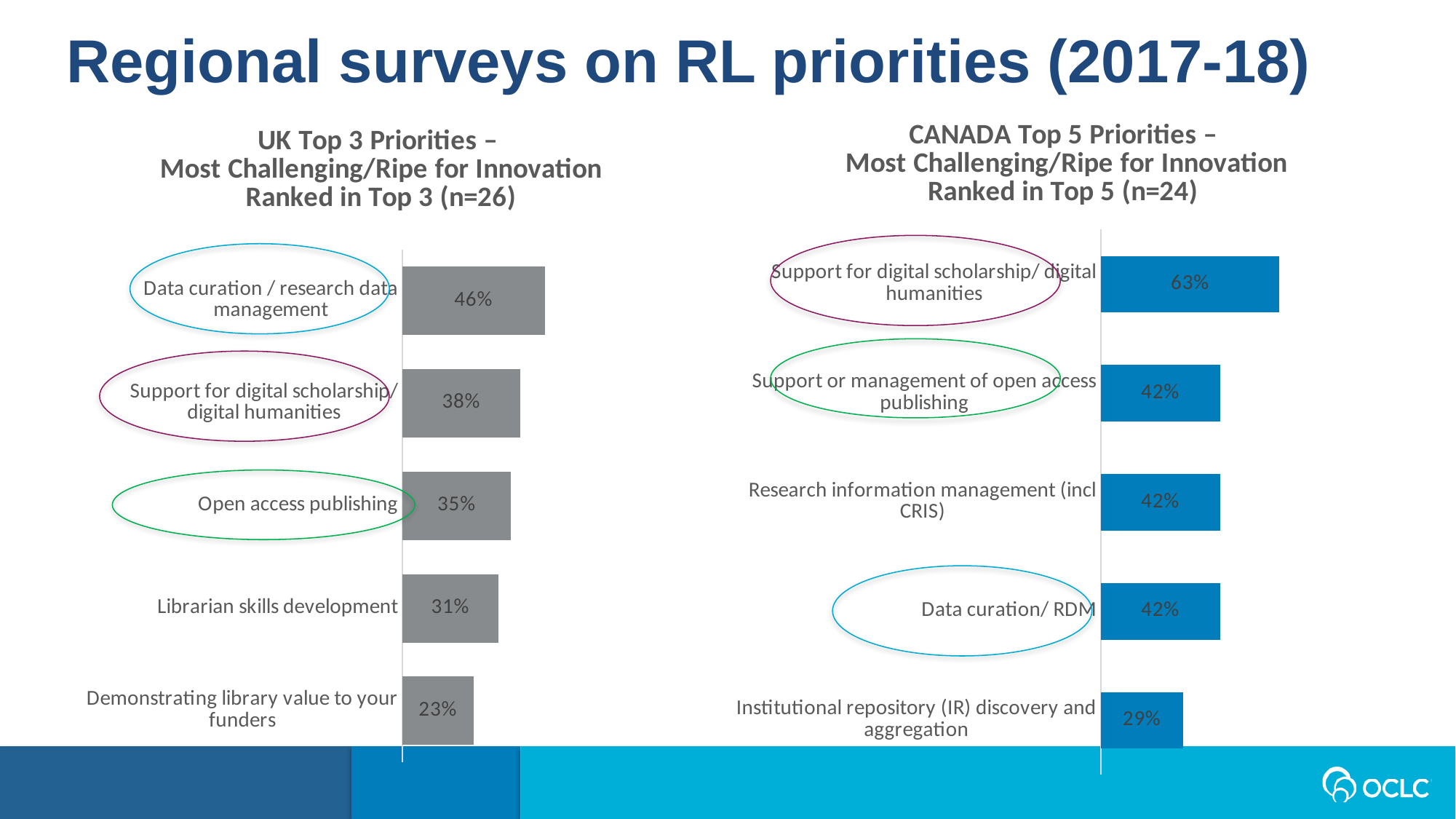
What type of chart is the UK Top 3 Priorities chart? Bar chart In the CANADA Top 5 Priorities chart, what is the value for Support for digital scholarship/ digital humanities? 63% In the CANADA Top 5 Priorities chart, which category has the highest value? Support for digital scholarship/ digital humanities In the UK Top 3 Priorities chart, what is the value for Librarian skills development? 31% In the CANADA Top 5 Priorities chart, what is the value for Institutional repository (IR) discovery and aggregation? 29% In the UK Top 3 Priorities chart, which is larger: Support for digital scholarship/ digital humanities or Librarian skills development? Support for digital scholarship/ digital humanities In the UK Top 3 Priorities chart, which category has the lowest value? Demonstrating library value to your funders In the UK Top 3 Priorities chart, what is the difference between Data curation / research data management and Open access publishing? 11% What colour are the bars in the CANADA Top 5 Priorities chart? Blue In the UK Top 3 Priorities chart, what is the value for Data curation / research data management? 46% How many categories are shown in the CANADA Top 5 Priorities chart? 5 In the CANADA Top 5 Priorities chart, what is the difference between Support for digital scholarship/ digital humanities and Data curation/ RDM? 21%